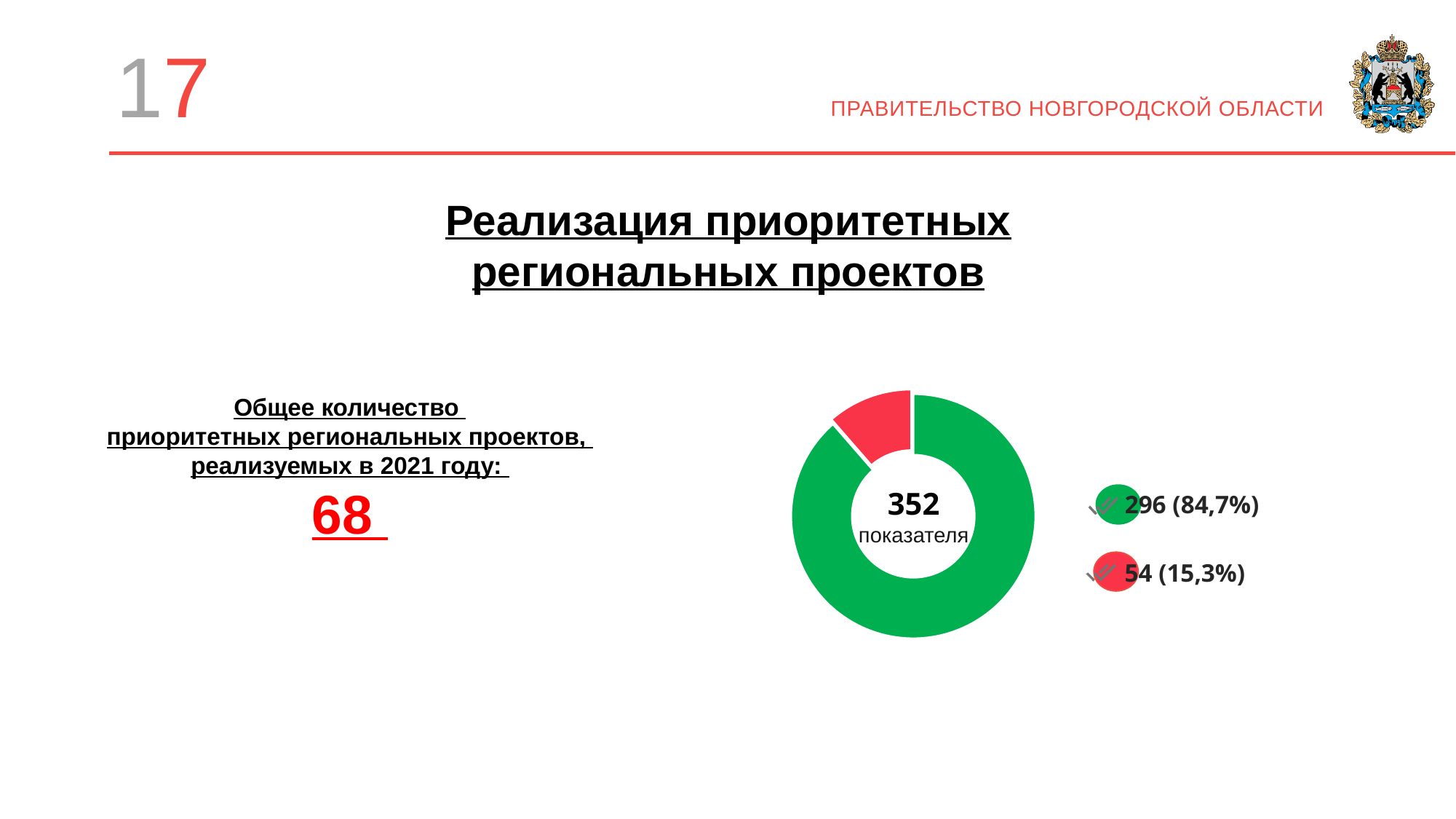
What kind of chart is shown on the slide? Donut (pie) chart What share of the donut chart does the red segment represent? 15,3% What is the difference between the green segment value and the red segment value in the donut chart? 242 What share of the donut chart does the green segment represent? 84,7% Which segment of the donut chart is the largest? The green segment (296) What word is printed under the number 352 in the centre of the donut chart? показателя What value is shown for the red segment of the donut chart? 54 (15,3%) Which is larger in the donut chart: the green segment or the red segment? The green segment What total number is printed in the centre of the donut chart? 352 How many segments does the donut chart have? 2 Which segment of the donut chart is the smallest? The red segment (54) What value is shown for the green segment of the donut chart? 296 (84,7%)